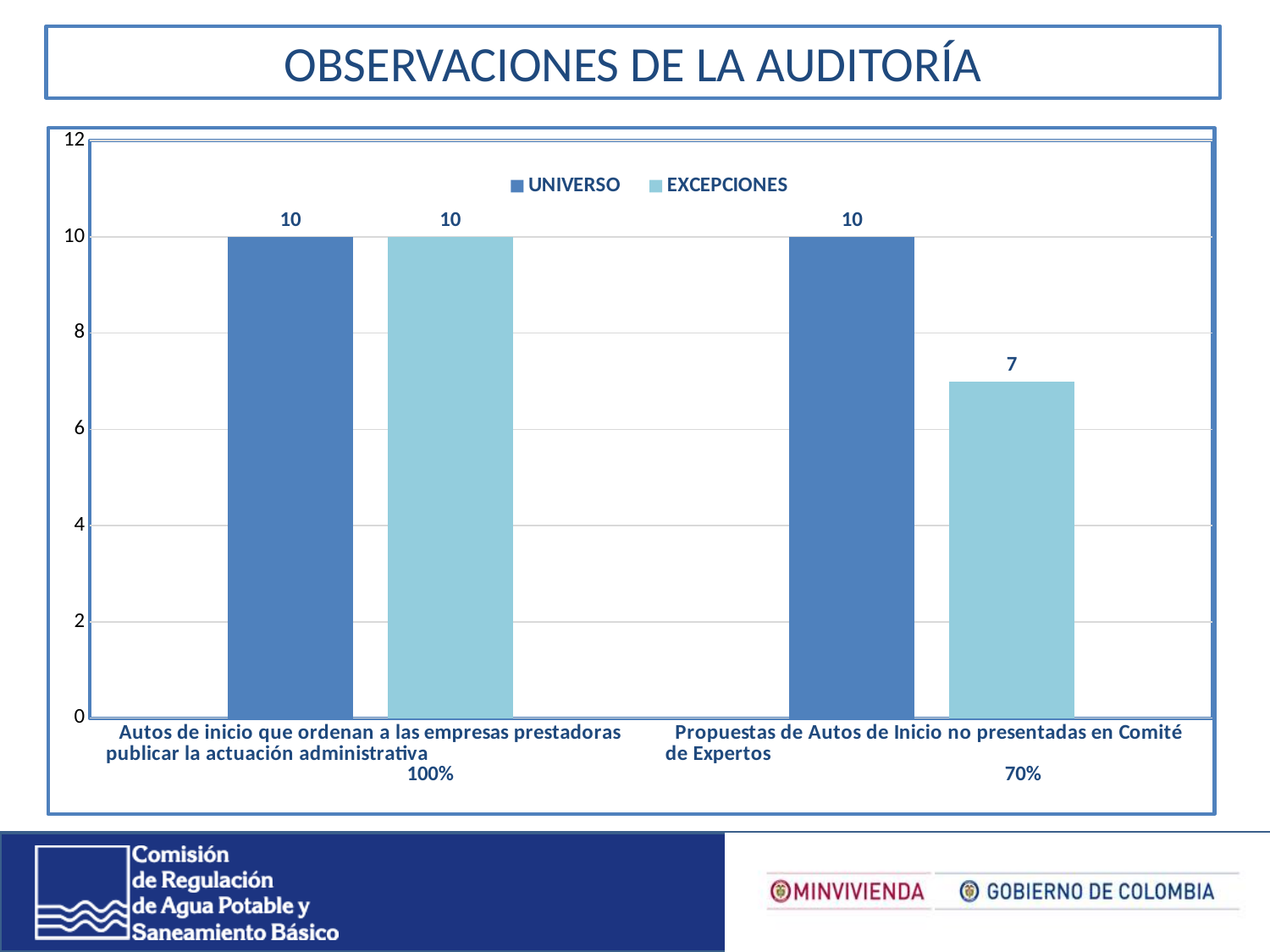
What is the UNIVERSO value for 'Propuestas de Autos de Inicio no presentadas en Comité de Expertos'? 10 What percentage is shown under 'Propuestas de Autos de Inicio no presentadas en Comité de Expertos'? 70% Is the EXCEPCIONES value for 'Propuestas de Autos de Inicio no presentadas en Comité de Expertos' greater or less than 8? less How many categories are shown on the x axis? 2 What is the UNIVERSO value for 'Autos de inicio que ordenan a las empresas prestadoras publicar la actuación administrativa'? 10 Which category has the lowest EXCEPCIONES value? Propuestas de Autos de Inicio no presentadas en Comité de Expertos What is the difference between the UNIVERSO and EXCEPCIONES values for 'Propuestas de Autos de Inicio no presentadas en Comité de Expertos'? 3 How many series does the legend list? 2 For 'Propuestas de Autos de Inicio no presentadas en Comité de Expertos', which is larger, UNIVERSO or EXCEPCIONES? UNIVERSO What kind of chart is shown on the slide? bar chart What is the EXCEPCIONES value for 'Propuestas de Autos de Inicio no presentadas en Comité de Expertos'? 7 What is the EXCEPCIONES value for 'Autos de inicio que ordenan a las empresas prestadoras publicar la actuación administrativa'? 10